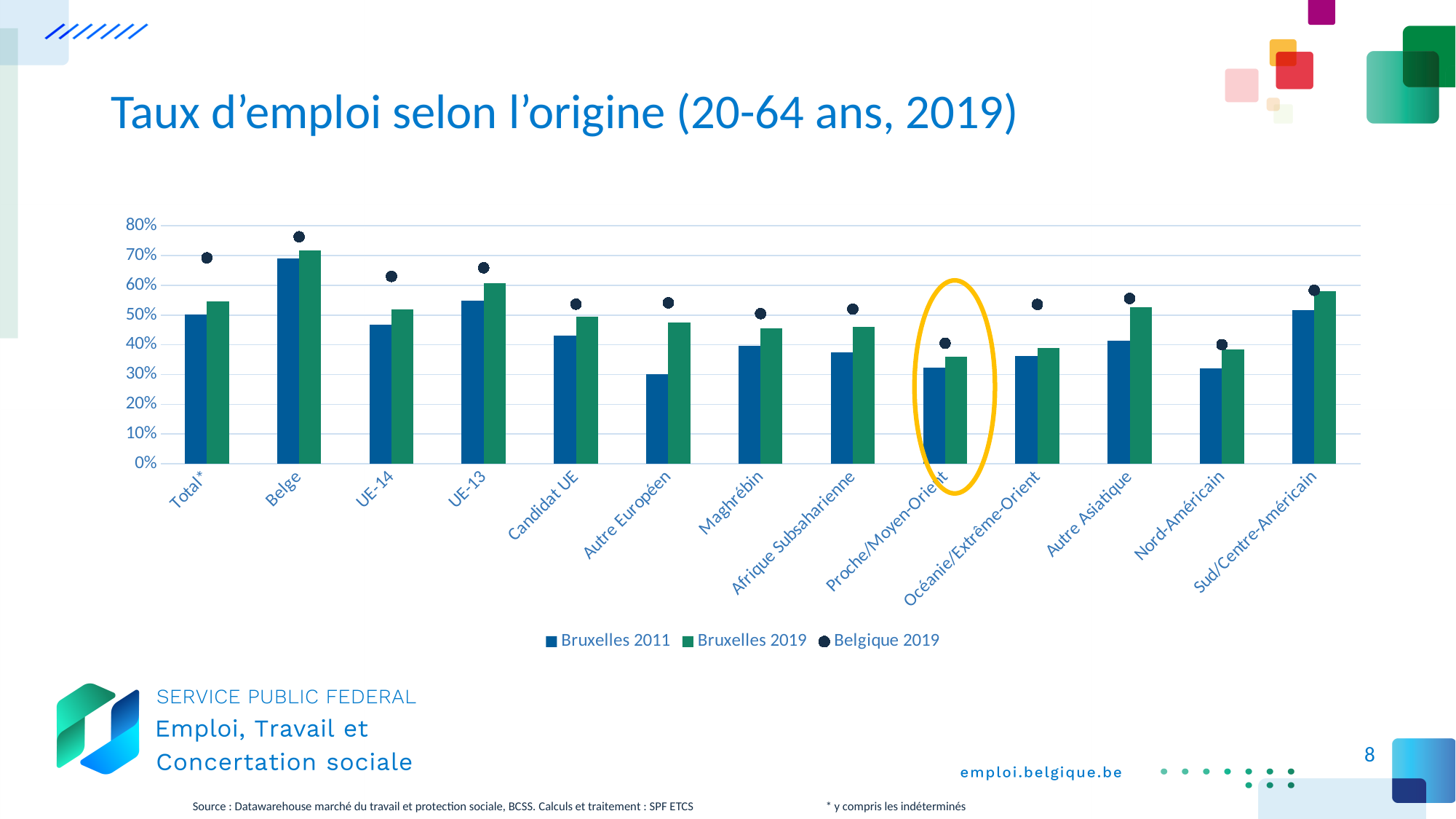
Which category has the highest Belgique 2019 value? Belge Is the Bruxelles 2019 value for Total* greater or less than 50%? greater For Belge, which is larger: Bruxelles 2019 or Belgique 2019? Belgique 2019 Which category has the lowest Bruxelles 2011 value? Autre Européen What kind of chart is shown on the slide? Combination chart: bars (Bruxelles 2011 and 2019) with dot markers (Belgique 2019) For Autre Européen, which is larger: Bruxelles 2011 or Bruxelles 2019? Bruxelles 2019 How many origin categories are shown on the x axis? 13 How many series does the legend list? 3 Which category has the highest Bruxelles 2019 value? Belge Which category is highlighted with a yellow circle on the chart? Proche/Moyen-Orient Is the Bruxelles 2011 value for Autre Européen greater or less than 40%? less Is the Bruxelles 2011 value for Belge greater or less than 60%? greater